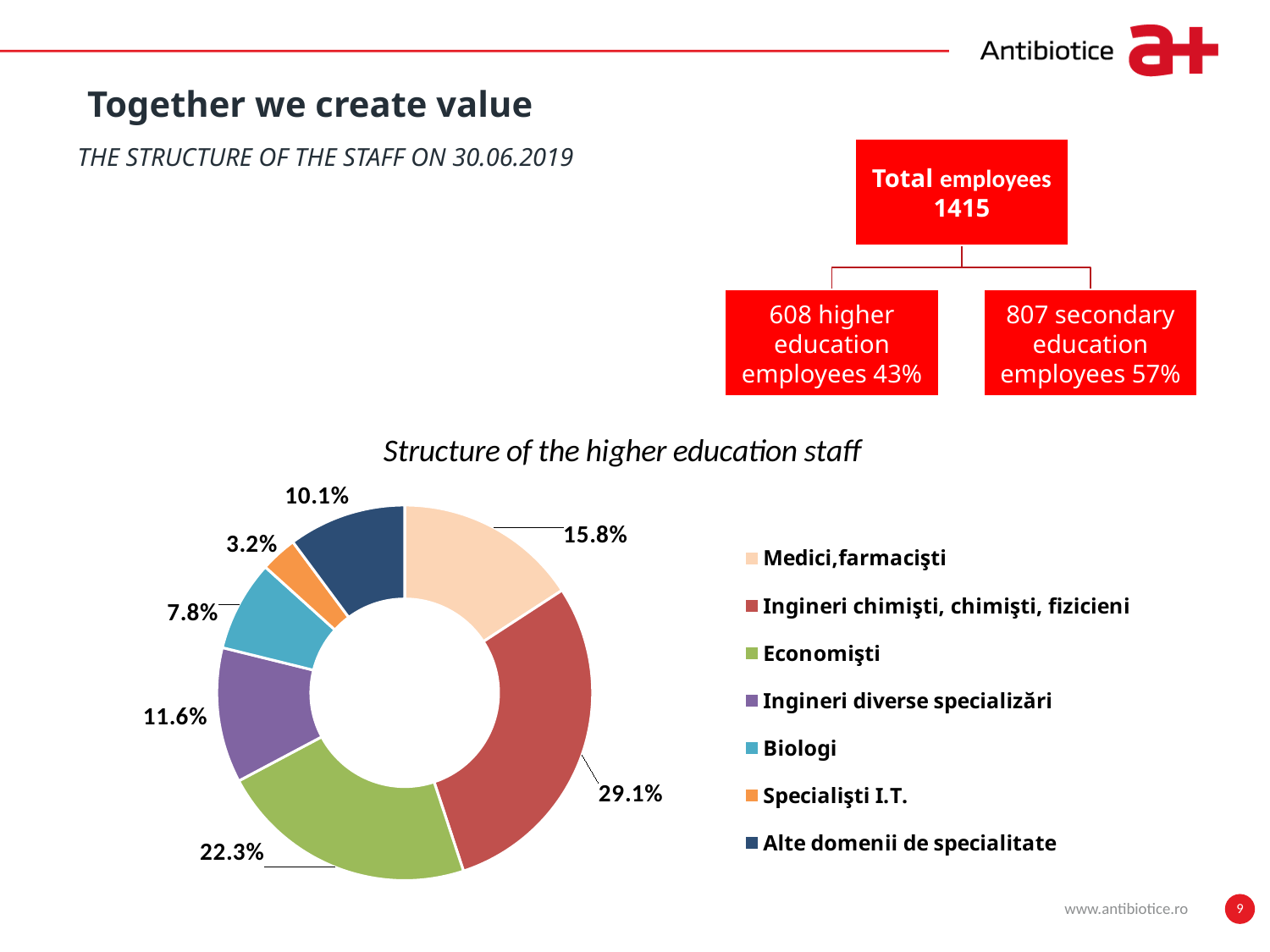
How many categories does the 'Structure of the higher education staff' chart show? 7 What kind of chart is shown under 'Structure of the higher education staff'? Doughnut (pie) chart What share of the higher education staff is 'Alte domenii de specialitate'? 10.1% Which is larger: the share of 'Ingineri diverse specializări' or the share of 'Alte domenii de specialitate'? Ingineri diverse specializări What share of the higher education staff is 'Ingineri chimişti, chimişti, fizicieni'? 29.1% Which category has the smallest share of the higher education staff? Specialişti I.T. What share of the higher education staff is 'Biologi'? 7.8% Which colour represents 'Medici,farmacişti' in the chart? Light peach What share of the higher education staff is 'Specialişti I.T.'? 3.2% What is the difference in percentage points between 'Economişti' and 'Medici,farmacişti'? 6.5 Which category has the largest share of the higher education staff? Ingineri chimişti, chimişti, fizicieni What share of the higher education staff is 'Economişti'? 22.3%